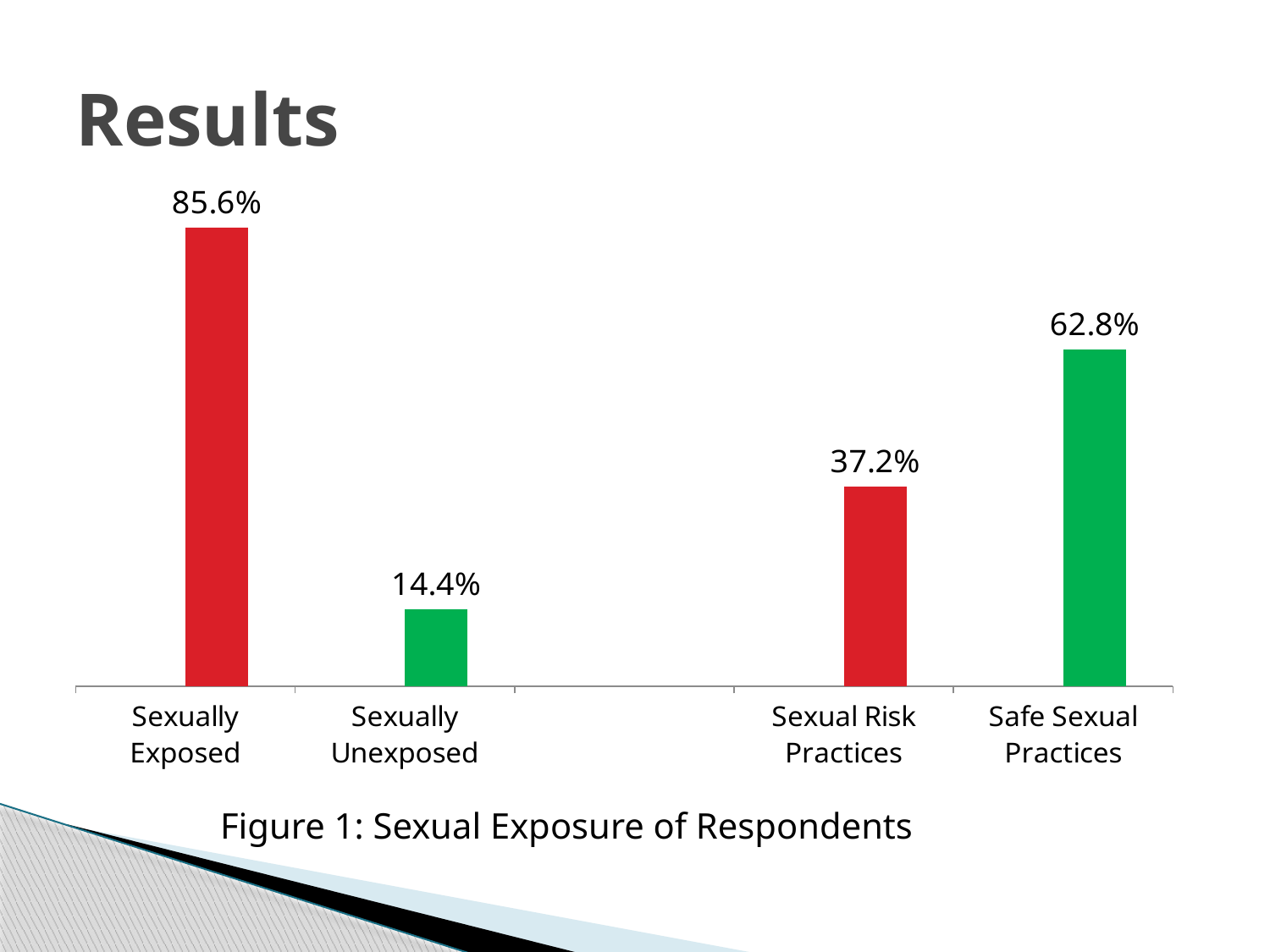
Which is larger, the value for Sexual Risk Practices or the value for Safe Sexual Practices? Safe Sexual Practices Which category has the lowest value? Sexually Unexposed What is the difference between the values for Sexually Exposed and Sexually Unexposed? 71.2% What is the value for Sexually Exposed? 85.6% How many categories are shown in the chart? 4 What is the figure caption below the chart? Figure 1: Sexual Exposure of Respondents What is the value for Sexually Unexposed? 14.4% What is the value for Safe Sexual Practices? 62.8% What is the value for Sexual Risk Practices? 37.2% What is the difference between the values for Safe Sexual Practices and Sexual Risk Practices? 25.6% What kind of chart is shown on the slide? Bar chart Which category has the highest value? Sexually Exposed